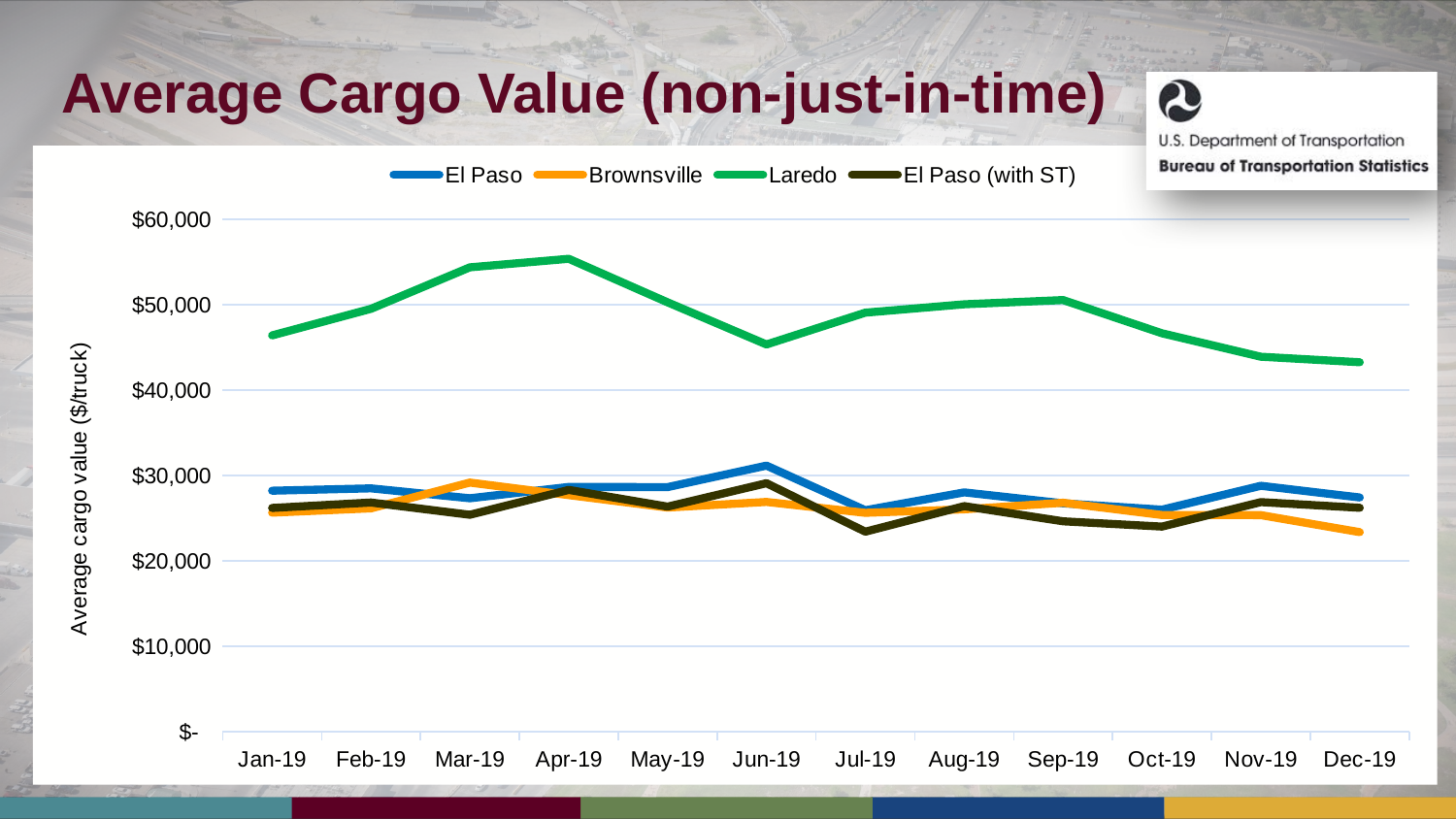
What kind of chart is shown on the slide? Line chart What is the label on the y axis? Average cargo value ($/truck) How many months are plotted along the x axis? 12 How many series does the legend list? 4 Which series has the lowest value in Dec-19? Brownsville Does the Laredo line rise or fall from Sep-19 to Dec-19? Fall Which series has the highest average cargo value across all months? Laredo Which is larger in Mar-19, the value for Brownsville or the value for El Paso? Brownsville Is the value for Laredo in Jan-19 greater or less than $50,000? less Is the value for Laredo in Apr-19 greater or less than $50,000? greater What colour is the Laredo line in the legend? Green Is the value for El Paso (with ST) in Jul-19 greater or less than $25,000? less